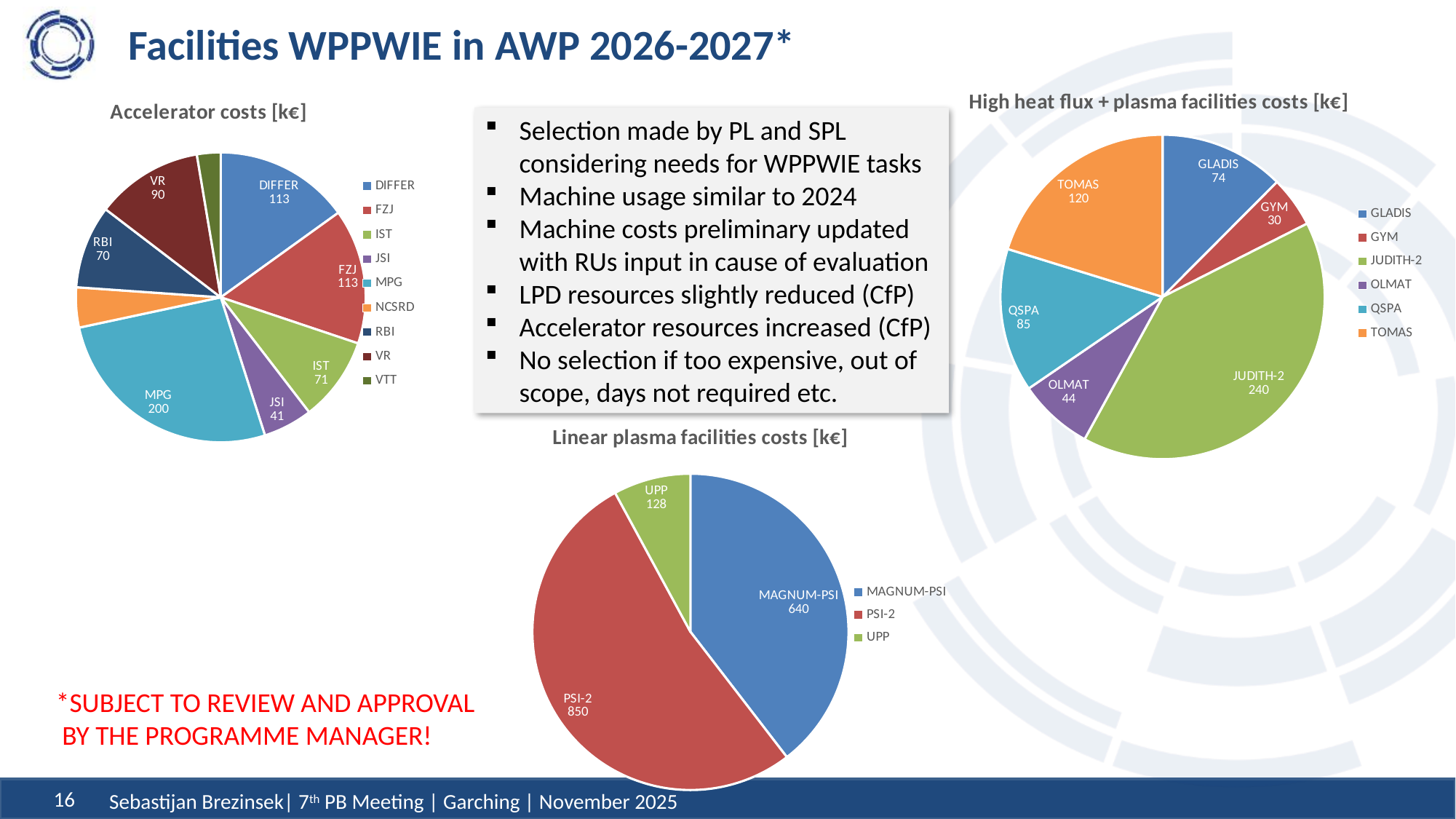
In the 'High heat flux + plasma facilities costs [k€]' chart, which category has the smallest value? GYM In the 'Accelerator costs [k€]' chart, what is the value for MPG? 200 In the 'Accelerator costs [k€]' chart, what is the difference between the values for VR and RBI? 20 In the 'Accelerator costs [k€]' chart, which category has the largest slice? MPG In the 'High heat flux + plasma facilities costs [k€]' chart, which is larger, TOMAS or GLADIS? TOMAS In the 'High heat flux + plasma facilities costs [k€]' chart, what is the difference between JUDITH-2 and OLMAT? 196 In the 'High heat flux + plasma facilities costs [k€]' chart, what is the value for QSPA? 85 In the 'Linear plasma facilities costs [k€]' chart, how many categories are shown? 3 In the 'Accelerator costs [k€]' chart, how many entries does the legend list? 9 In the 'Accelerator costs [k€]' chart, what is the value for JSI? 41 In the 'Linear plasma facilities costs [k€]' chart, what is the value for PSI-2? 850 What type of chart is the 'Linear plasma facilities costs [k€]' chart? Pie chart